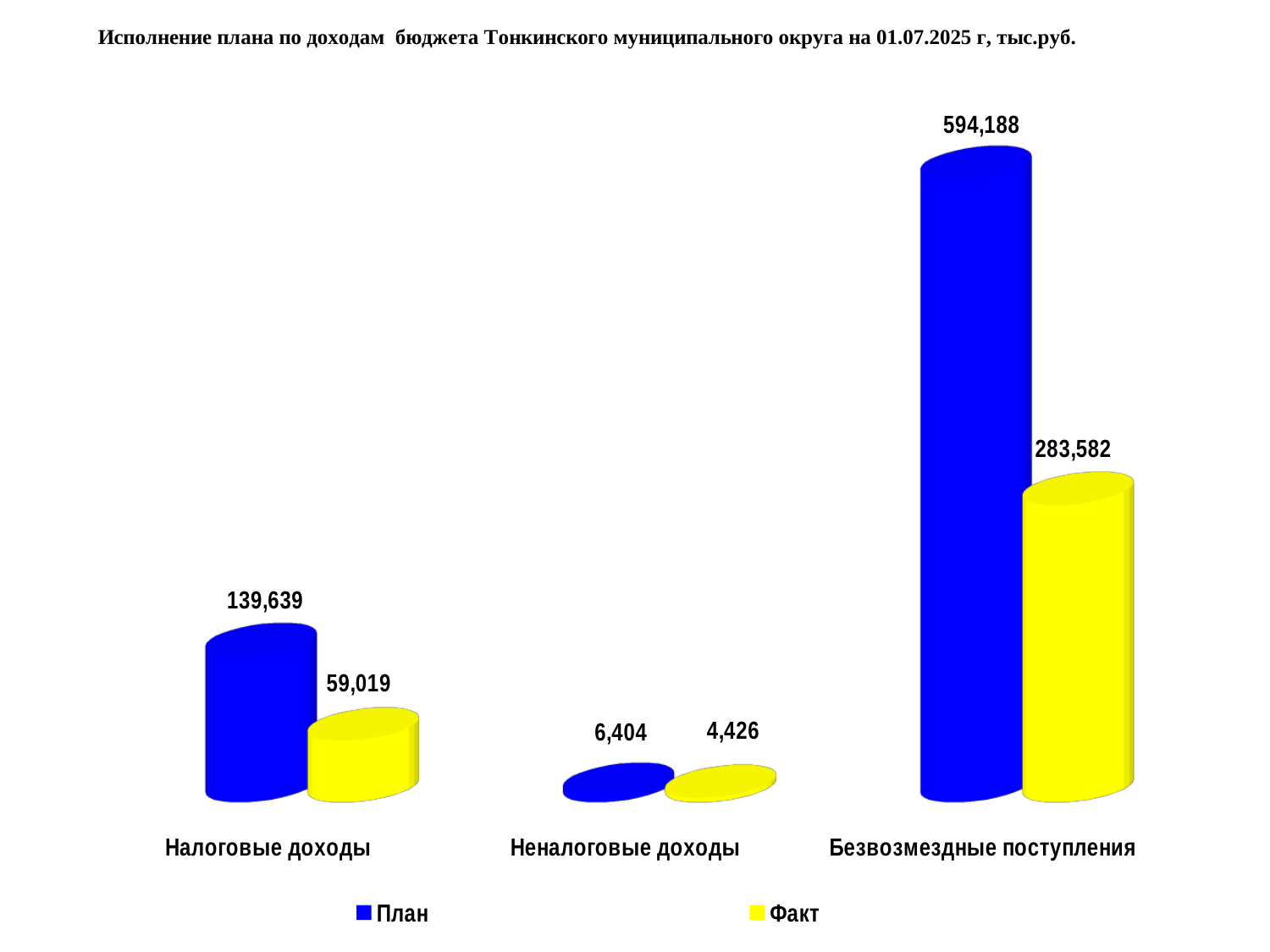
Which category has the lowest Факт value? Неналоговые доходы What is the Факт value for Безвозмездные поступления? 283,582 What kind of chart is shown on the slide? Bar chart How many categories are shown on the x axis? 3 Which is larger for Неналоговые доходы, the План value or the Факт value? План How many series does the legend list? 2 What is the difference between the План and Факт values for Безвозмездные поступления? 310,606 Which category has the highest План value? Безвозмездные поступления What is the Факт value for Неналоговые доходы? 4,426 Which colour represents the Факт series? Yellow What is the difference between the План and Факт values for Налоговые доходы? 80,620 What is the План value for Налоговые доходы? 139,639